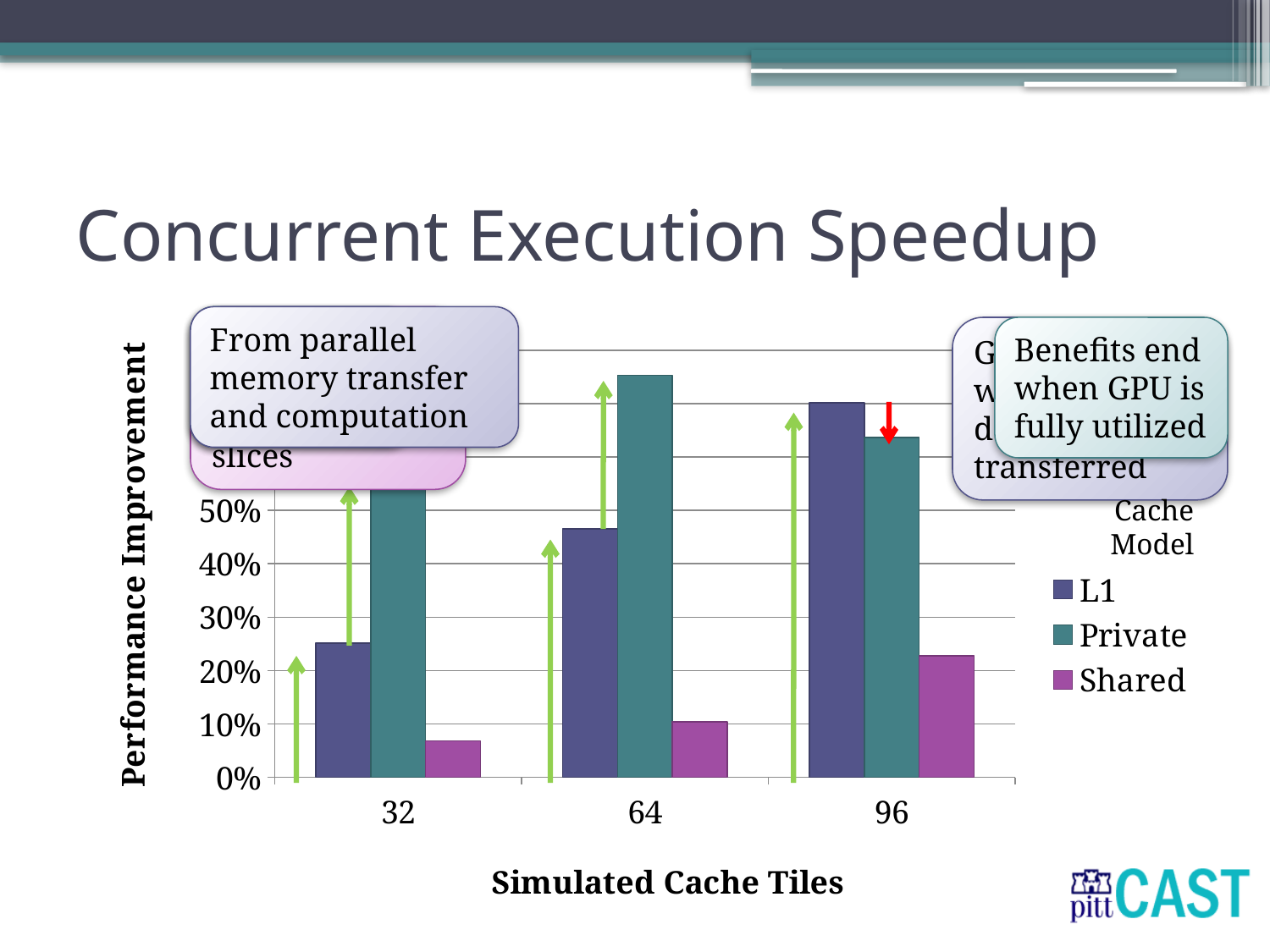
Which cache model has the lowest performance improvement at 32 simulated cache tiles? Shared Which cache model has the highest performance improvement at 64 simulated cache tiles? Private How many cache tile categories are shown on the x axis? 3 What kind of chart is shown on the slide? bar chart Is the Shared value at 64 simulated cache tiles greater or less than 20%? less At which number of simulated cache tiles is the Shared performance improvement highest? 96 Does the Shared series rise or fall as the number of simulated cache tiles increases from 32 to 96? rises At 96 simulated cache tiles, which is larger: the L1 bar or the Private bar? L1 How many series does the legend list? 3 What is the title of the x axis? Simulated Cache Tiles Is the L1 value at 64 simulated cache tiles greater or less than 40%? greater Is the L1 value at 32 simulated cache tiles greater or less than 30%? less